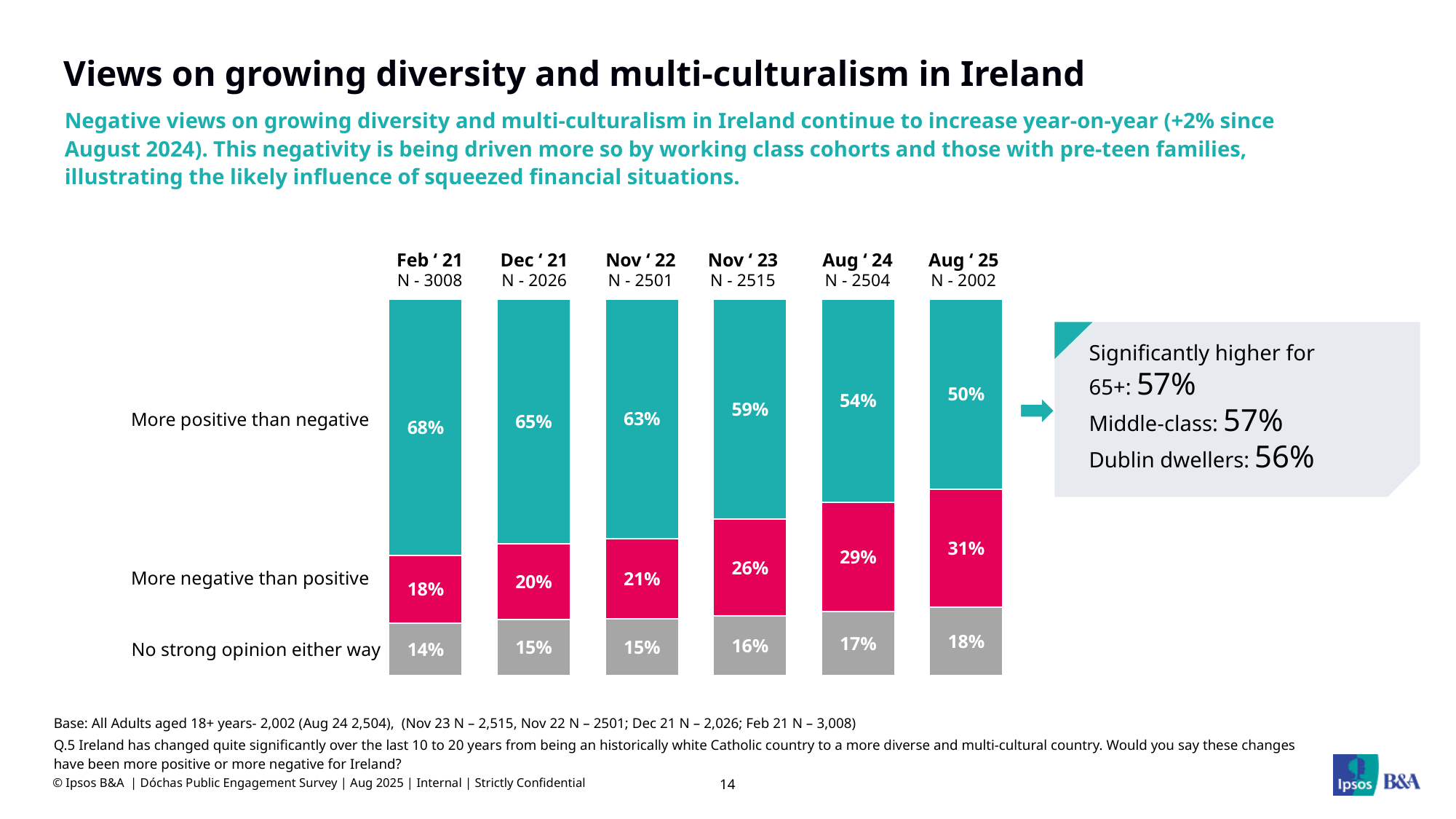
What percentage of respondents were 'More positive than negative' in Aug ' 25? 50% What percentage had 'No strong opinion either way' in Feb ' 21? 14% How many response categories are shown in each bar? 3 Which is larger in Nov ' 22: 'More negative than positive' or 'No strong opinion either way'? More negative than positive What is the sample size (N) for the Aug ' 25 wave? N - 2002 In which wave was 'More negative than positive' lowest? Feb ' 21 In which wave was 'More positive than negative' highest? Feb ' 21 What percentage of respondents were 'More negative than positive' in Nov ' 23? 26% What kind of chart is shown on the slide? Stacked bar chart How many survey waves are shown in the chart? 6 Does the 'More positive than negative' share rise or fall from Feb ' 21 to Aug ' 25? Fall What is the difference between the 'More negative than positive' share in Aug ' 25 and Aug ' 24? 2%